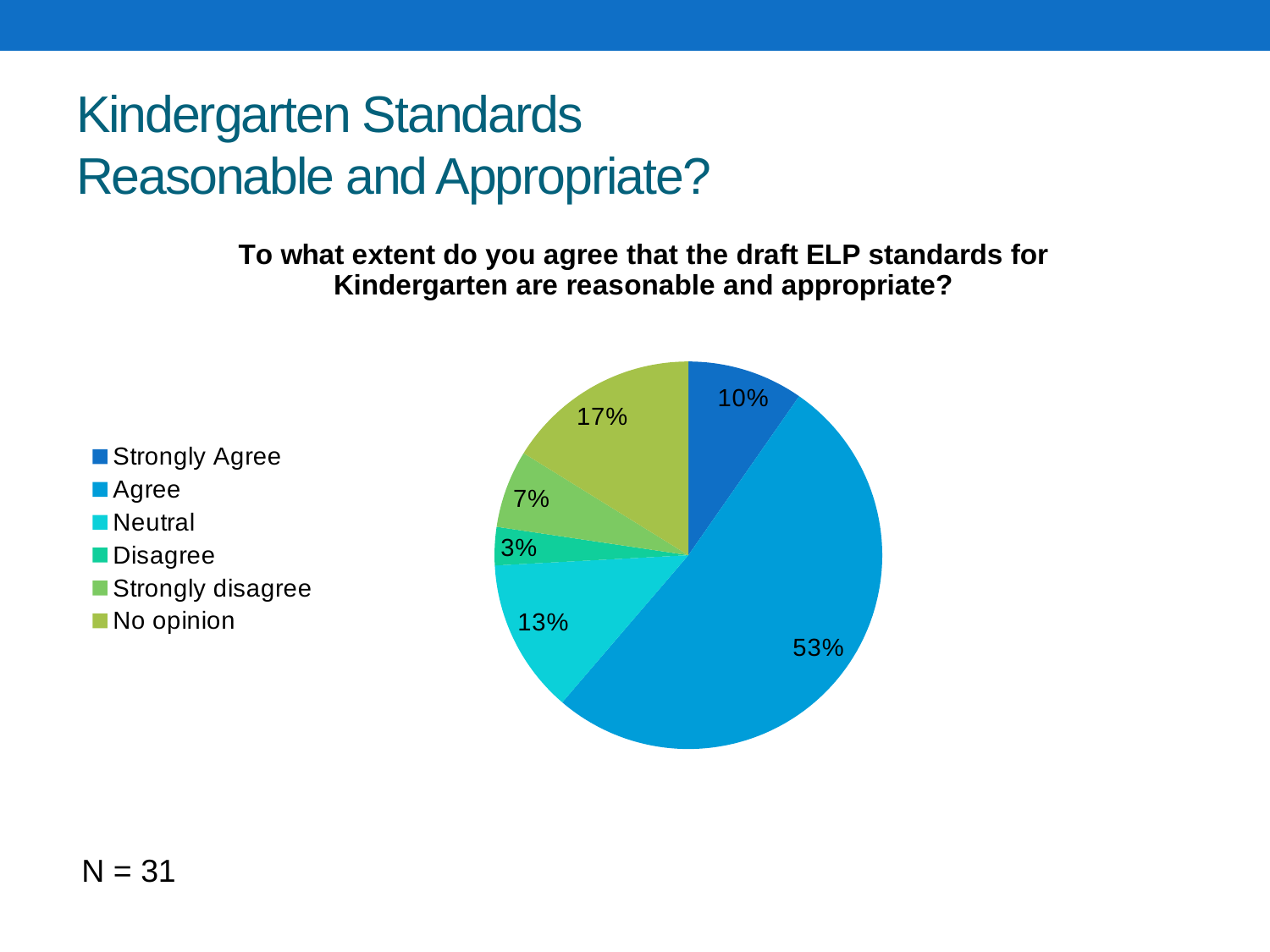
What percentage of respondents chose Agree? 53% What is the difference in percentage points between Agree and Neutral? 40 What kind of chart is shown on the slide? pie chart Which response category has the largest share of the pie? Agree What percentage of respondents chose No opinion? 17% How many response categories does the legend list? 6 Which response category has the smallest share of the pie? Disagree What percentage of respondents chose Strongly Agree? 10% What percentage of respondents chose Neutral? 13% What is the combined percentage for Strongly Agree and Agree? 63% What percentage of respondents chose Disagree? 3% Which is larger, the share for No opinion or the share for Strongly Agree? No opinion